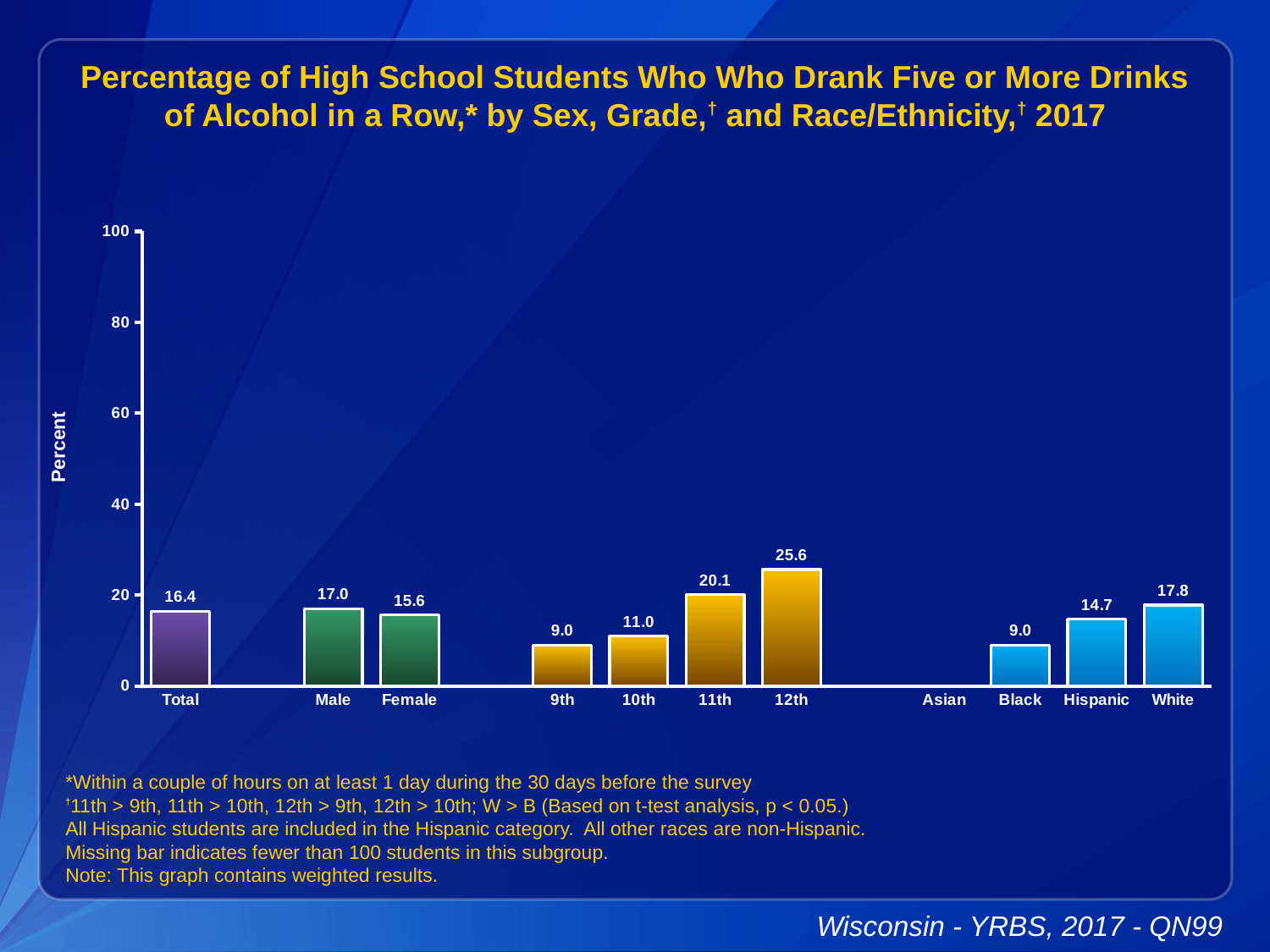
Which race/ethnicity category has no bar shown? Asian What is the value for Total? 16.4 What is the value for Hispanic students? 14.7 What is the difference between the Male and Female values? 1.4 Which category has the highest value on the chart? 12th Is the value for 11th grade greater or less than 20? greater What percentage of 12th grade students drank five or more drinks in a row? 25.6 How many categories on the x axis have a bar plotted? 10 Which is larger, the value for White or the value for Black? White Which grade has the lowest value? 9th What is the difference between the 12th grade and 9th grade values? 16.6 What kind of chart is shown on the slide? bar chart